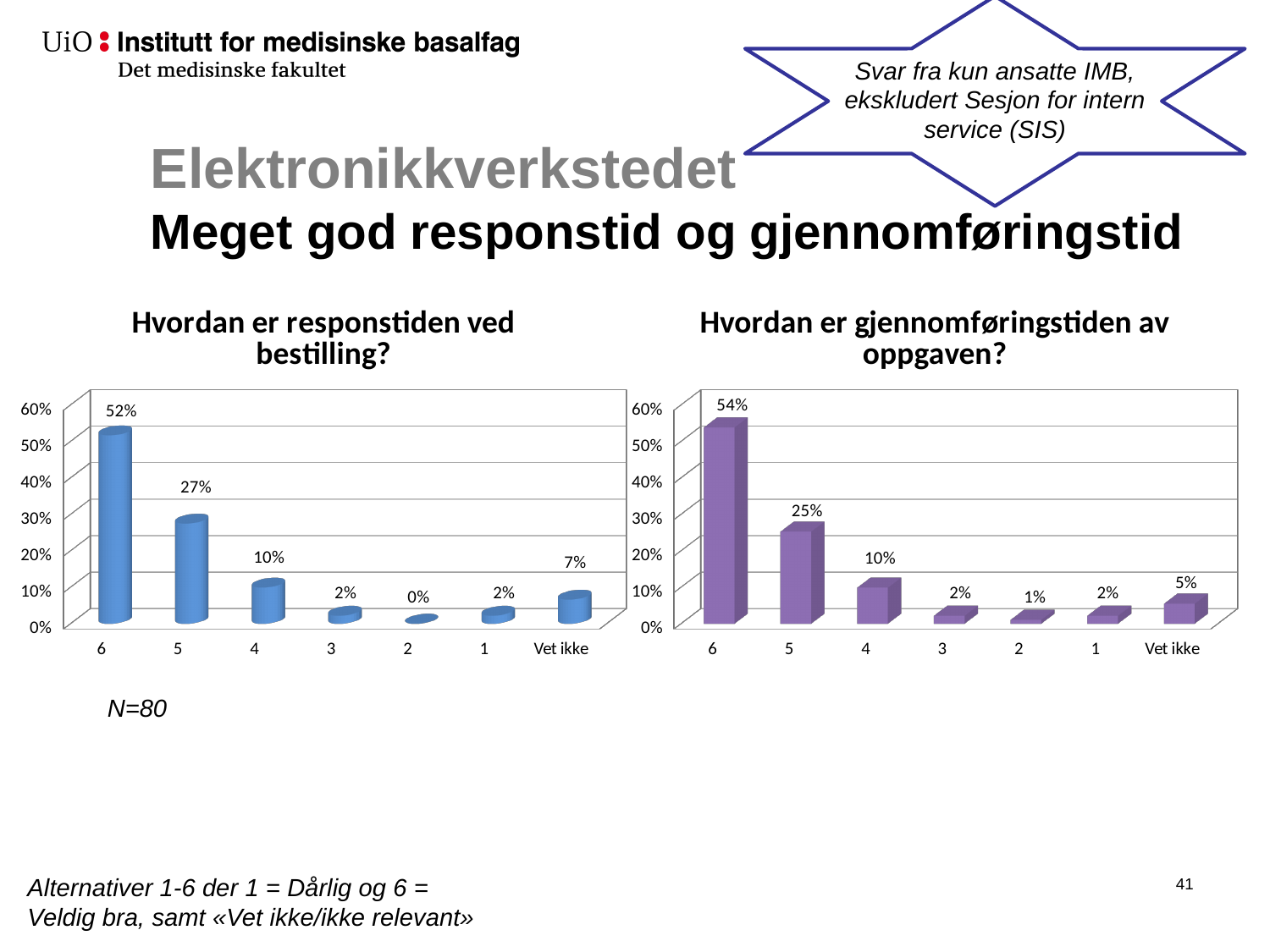
In the chart 'Hvordan er responstiden ved bestilling?', what is the value for category 6? 52% How many categories are shown on the x axis of the chart 'Hvordan er responstiden ved bestilling?'? 7 Which is larger: the value for category 6 in the left chart or the value for category 6 in the right chart? The right chart (54%) In the chart 'Hvordan er responstiden ved bestilling?', which category has the lowest value? 2 In the chart 'Hvordan er gjennomføringstiden av oppgaven?', what is the difference between the values for category 4 and 'Vet ikke'? 5% In the chart 'Hvordan er gjennomføringstiden av oppgaven?', is the value for category 5 greater or less than 30%? less In the chart 'Hvordan er responstiden ved bestilling?', what is the difference between the values for category 6 and category 5? 25% In the chart 'Hvordan er responstiden ved bestilling?', do the values generally rise or fall from category 6 to category 2? Fall What kind of chart is 'Hvordan er gjennomføringstiden av oppgaven?'? Bar chart In the chart 'Hvordan er responstiden ved bestilling?', what is the value for 'Vet ikke'? 7% In the chart 'Hvordan er gjennomføringstiden av oppgaven?', which category has the highest value? 6 In the chart 'Hvordan er gjennomføringstiden av oppgaven?', what is the value for category 5? 25%